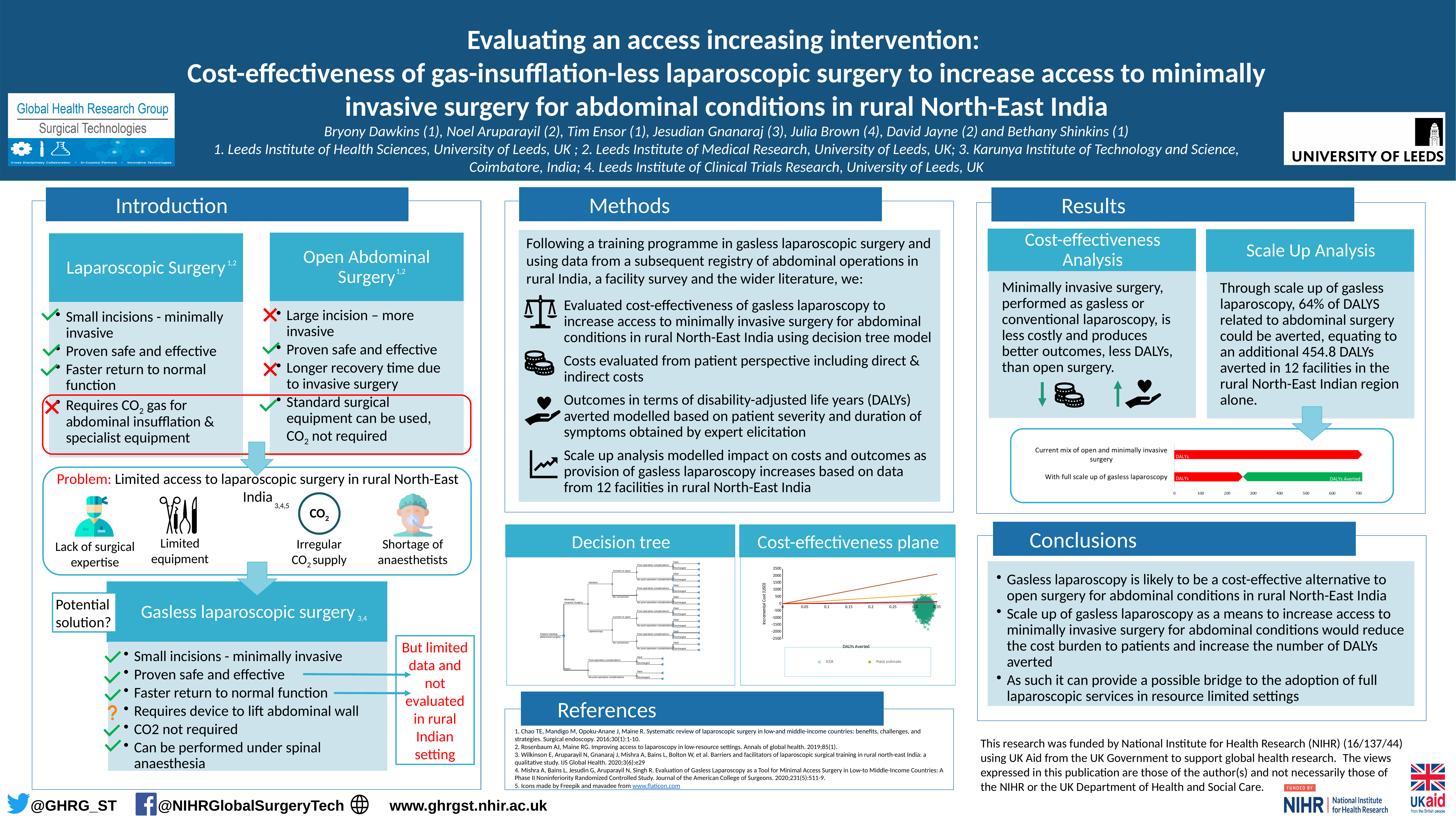
On the Results bar chart, is the DALYs value for 'With full scale up of gasless laparoscopy' greater or less than 400? less What is the label of the vertical axis on the 'Cost-effectiveness plane' chart? Incremental Cost (USD) What kind of chart is shown in the Results section comparing the current mix of surgery with full scale up of gasless laparoscopy? bar chart What is the highest tick value shown on the horizontal axis of the Results bar chart? 700 How many categories are shown on the bar chart in the Results section? 2 On the Results bar chart, is the DALYs value for 'Current mix of open and minimally invasive surgery' greater or less than 500? greater On the Results bar chart, which category has the larger DALYs bar: 'Current mix of open and minimally invasive surgery' or 'With full scale up of gasless laparoscopy'? Current mix of open and minimally invasive surgery On the Results bar chart, what colour is the 'DALYs Averted' bar? green What is the label of the horizontal axis on the 'Cost-effectiveness plane' chart? DALYs Averted What kind of chart is the 'Cost-effectiveness plane'? scatter chart What is the maximum value shown on the vertical axis of the 'Cost-effectiveness plane' chart? 2500 How many series does the legend of the 'Cost-effectiveness plane' chart list? 2